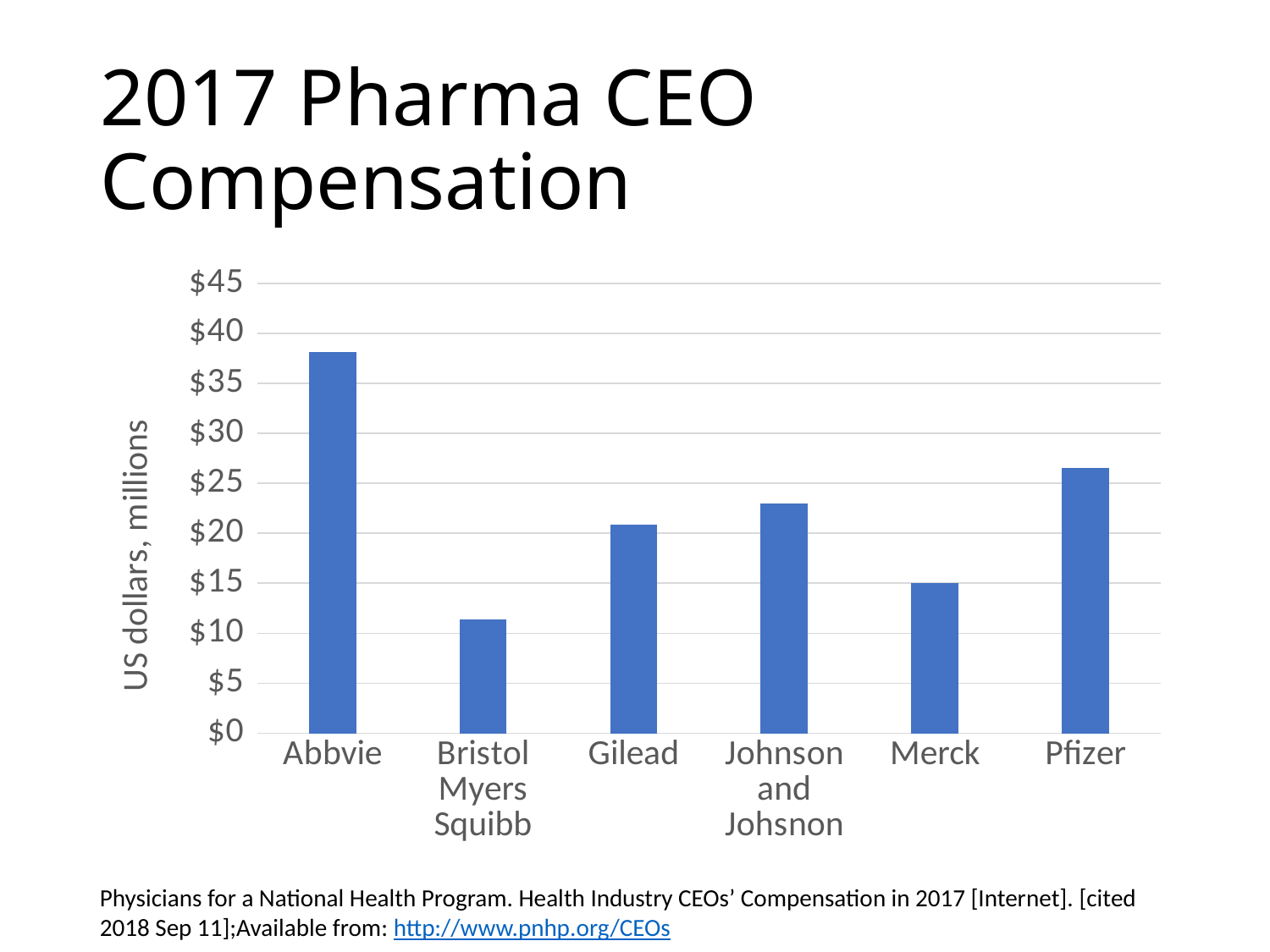
What is the label on the vertical axis of the chart? US dollars, millions Is the value for Bristol Myers Squibb greater or less than $15? less Which is larger, the value for Pfizer or the value for Merck? Pfizer Which company has the highest CEO compensation in the chart? Abbvie Which company has the lowest CEO compensation in the chart? Bristol Myers Squibb Which is larger, the value for Gilead or the value for Johnson and Johsnon? Johnson and Johsnon What kind of chart is shown on the slide? bar chart Is the value for Abbvie greater or less than $35? greater Is the value for Pfizer greater or less than $30? less How many companies are shown on the x axis of the chart? 6